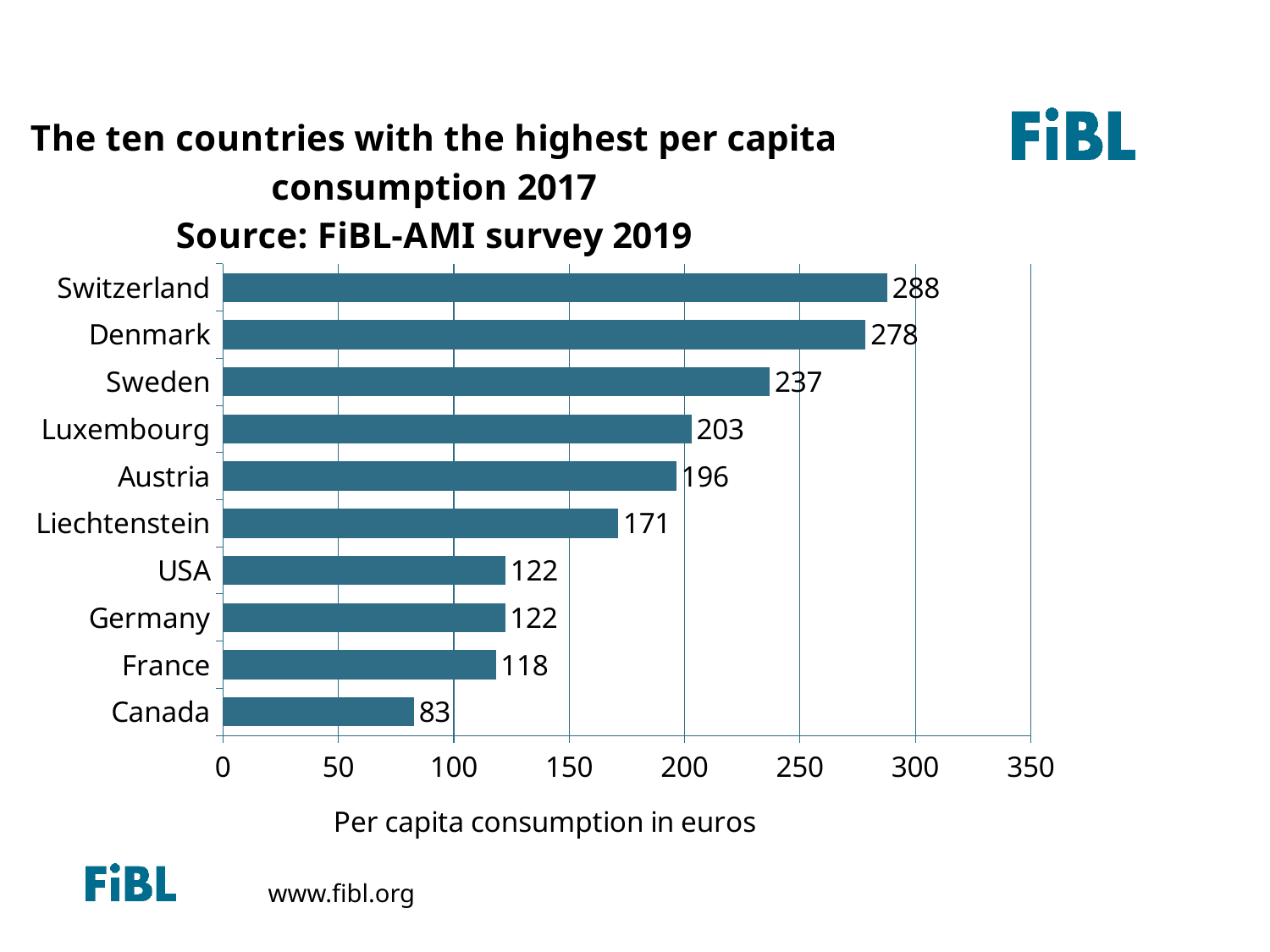
What is the x-axis label of the chart? Per capita consumption in euros Which country has the highest per capita consumption in the chart? Switzerland What is the difference between the values for Sweden and Liechtenstein? 66 What is the per capita consumption value shown for Luxembourg? 203 What is the per capita consumption value shown for Canada? 83 Which has a larger value, Austria or Liechtenstein? Austria What is the difference between the values for Switzerland and Denmark? 10 Is the value for Sweden greater or less than 200? greater How many countries are shown in the chart? 10 What is the per capita consumption value shown for Switzerland? 288 What kind of chart is shown on the slide? bar chart Which country has the lowest per capita consumption in the chart? Canada